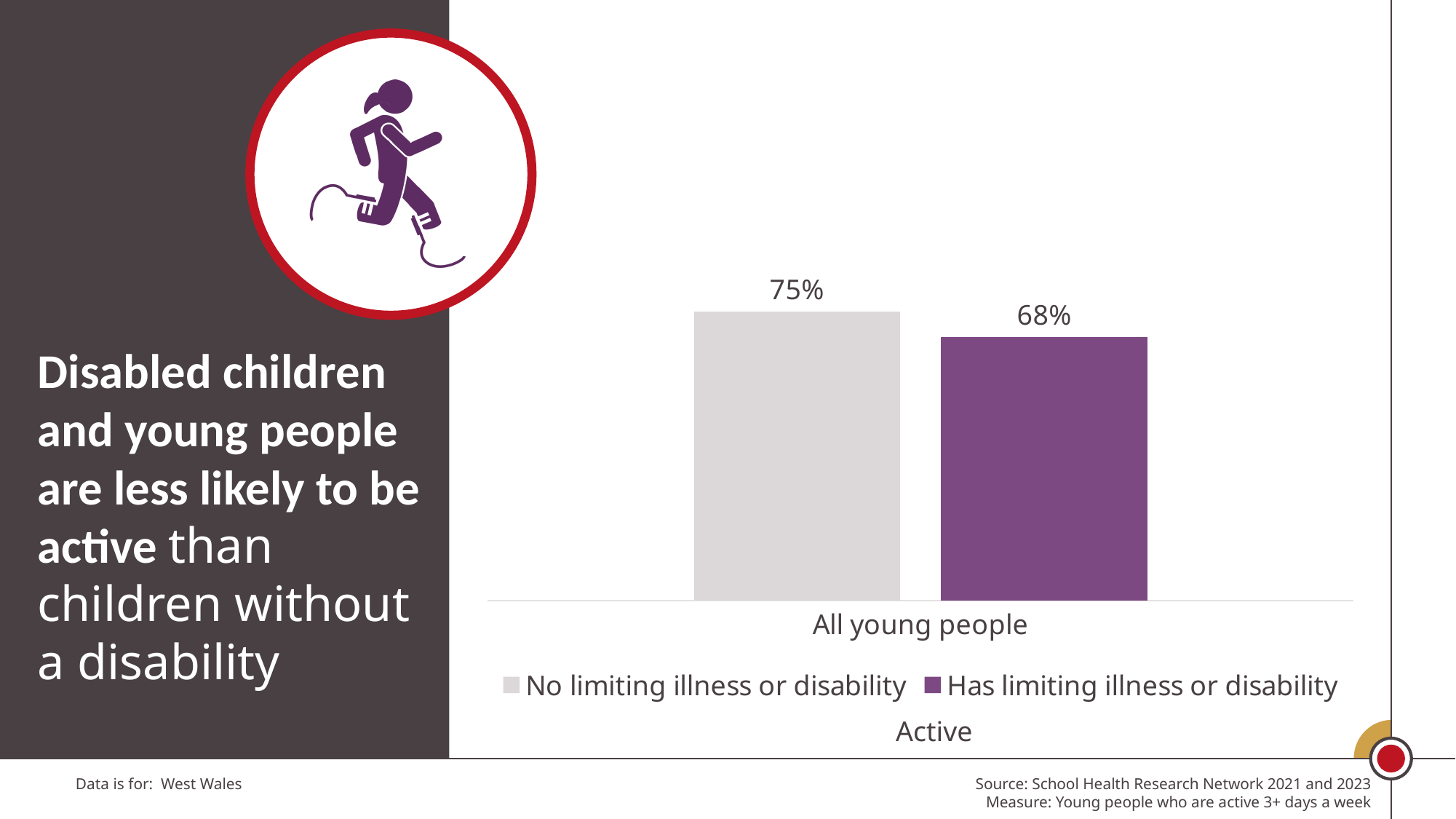
What percentage of young people with no limiting illness or disability are active? 75% How many categories are shown on the x axis? 1 What is the category label on the x axis? All young people Which series has the lower value for All young people? Has limiting illness or disability Is the value for No limiting illness or disability larger or smaller than the value for Has limiting illness or disability? larger What percentage of young people who have a limiting illness or disability are active? 68% What is the title of the chart? Active What is the difference in percentage points between the No limiting illness or disability bar and the Has limiting illness or disability bar? 7 What colour is the bar for Has limiting illness or disability? purple Which series has the higher value for All young people? No limiting illness or disability What kind of chart is shown on the slide? bar chart How many series does the legend list? 2